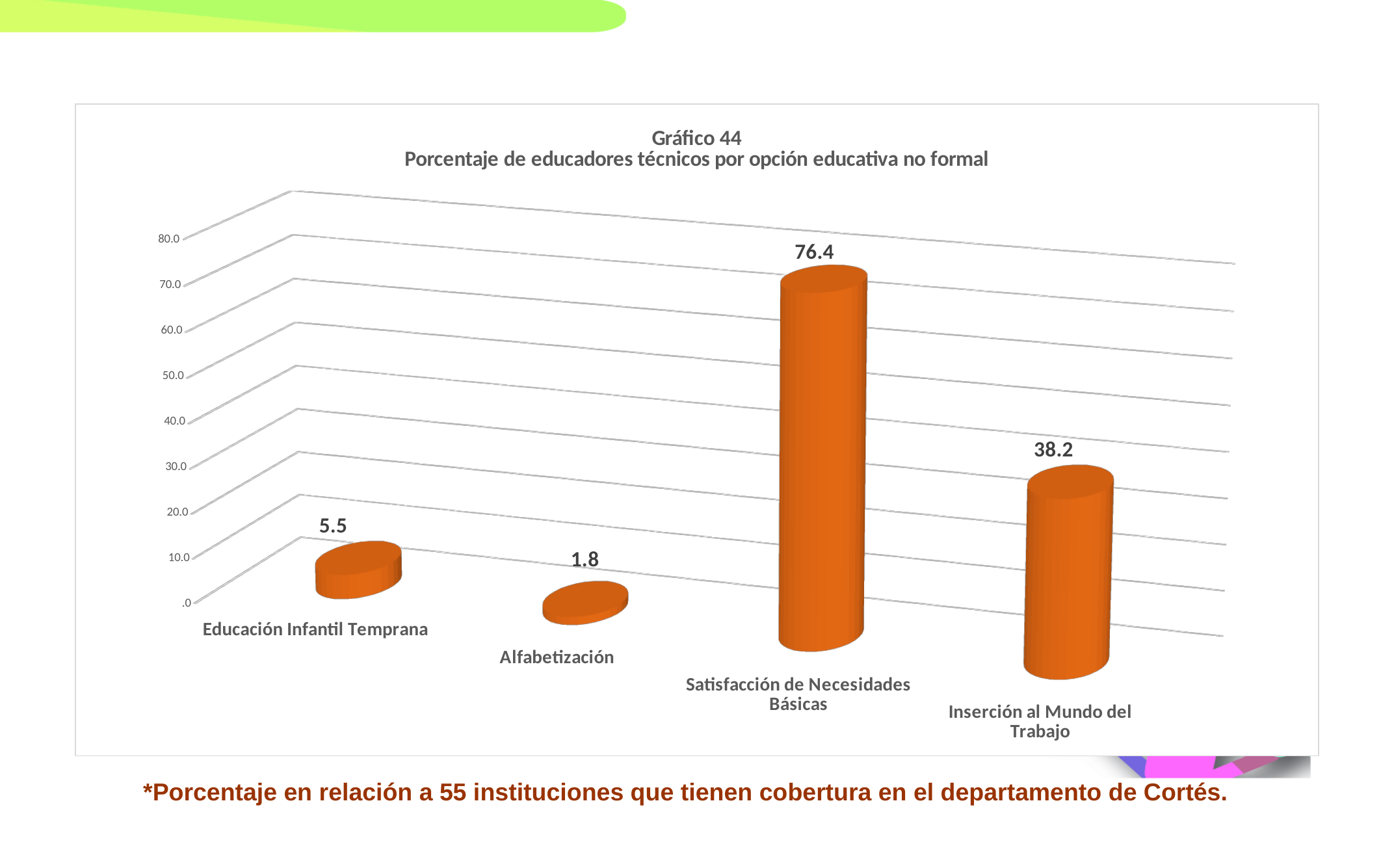
What is the difference between the values for Educación Infantil Temprana and Alfabetización? 3.7 How many categories are shown in the chart? 4 What is the value for Alfabetización? 1.8 What is the value for Inserción al Mundo del Trabajo? 38.2 What is the value for Satisfacción de Necesidades Básicas? 76.4 Which is larger, the value for Educación Infantil Temprana or the value for Inserción al Mundo del Trabajo? Inserción al Mundo del Trabajo What is the difference between the values for Satisfacción de Necesidades Básicas and Inserción al Mundo del Trabajo? 38.2 Which category has the highest value? Satisfacción de Necesidades Básicas Which category has the lowest value? Alfabetización What is the value for Educación Infantil Temprana? 5.5 What is the title of the chart? Gráfico 44 Porcentaje de educadores técnicos por opción educativa no formal What kind of chart is shown on the slide? Bar chart